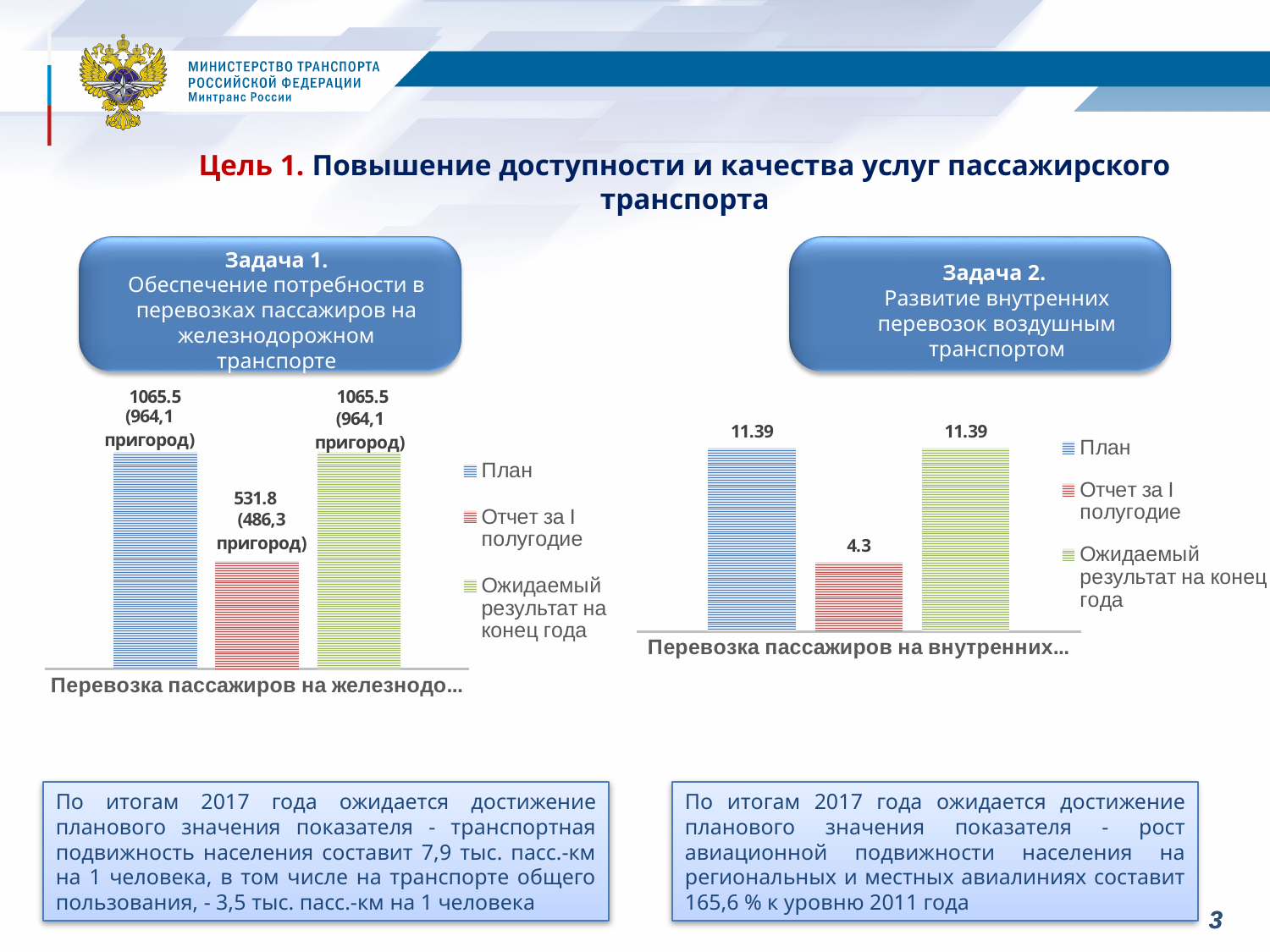
In the left chart, what is the value for План? 1065.5 In the left chart, which series has the lowest value? Отчет за I полугодие How many series does the legend of the right chart list? 3 In the right chart, what is the value for План? 11.39 In the left chart, what is the value for Отчет за I полугодие? 531.8 In the left chart, what is the value for Ожидаемый результат на конец года? 1065.5 In the right chart, what is the difference between the План value and the Отчет за I полугодие value? 7.09 In the right chart, what is the value for Отчет за I полугодие? 4.3 In the right chart, which series has the lowest value? Отчет за I полугодие In the right chart, what is the value for Ожидаемый результат на конец года? 11.39 In the left chart, what is the difference between the План value and the Отчет за I полугодие value? 533.7 What kind of chart is the left chart? bar chart